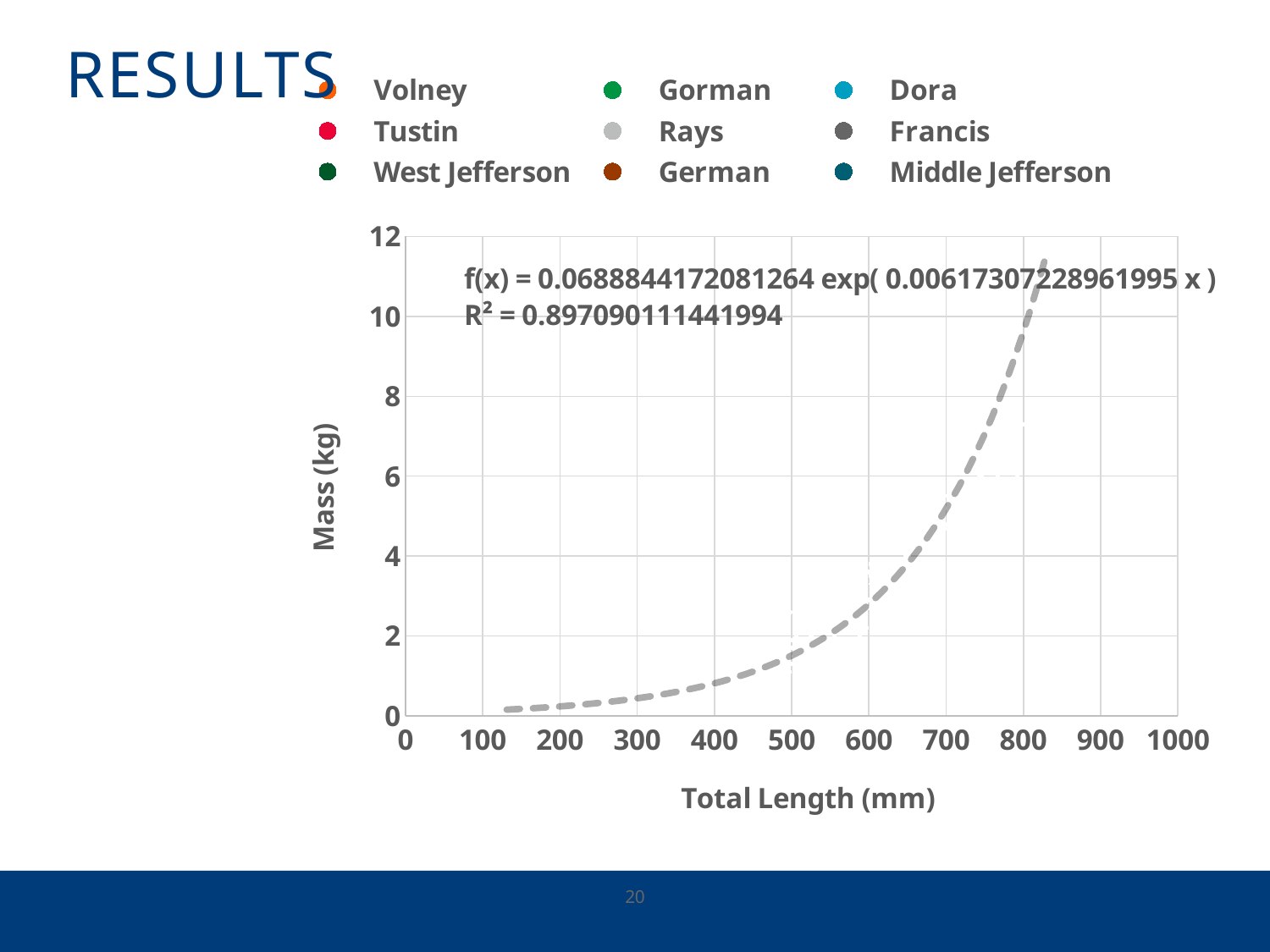
How many series does the legend list? 9 Is the value of the trendline at a Total Length of 500 mm greater or less than 2 kg? less Is the value of the trendline at a Total Length of 700 mm greater or less than 4 kg? greater What is the highest tick value shown on the x axis? 1000 Is the value of the trendline at a Total Length of 600 mm greater or less than 4 kg? less Does the fitted trendline rise or fall as Total Length increases? rises What is the title of the x axis? Total Length (mm) What is the title of the y axis? Mass (kg) What is the highest tick value shown on the y axis? 12 What is the R² value printed on the chart? 0.897090111441994 What kind of chart is shown on the slide? scatter chart